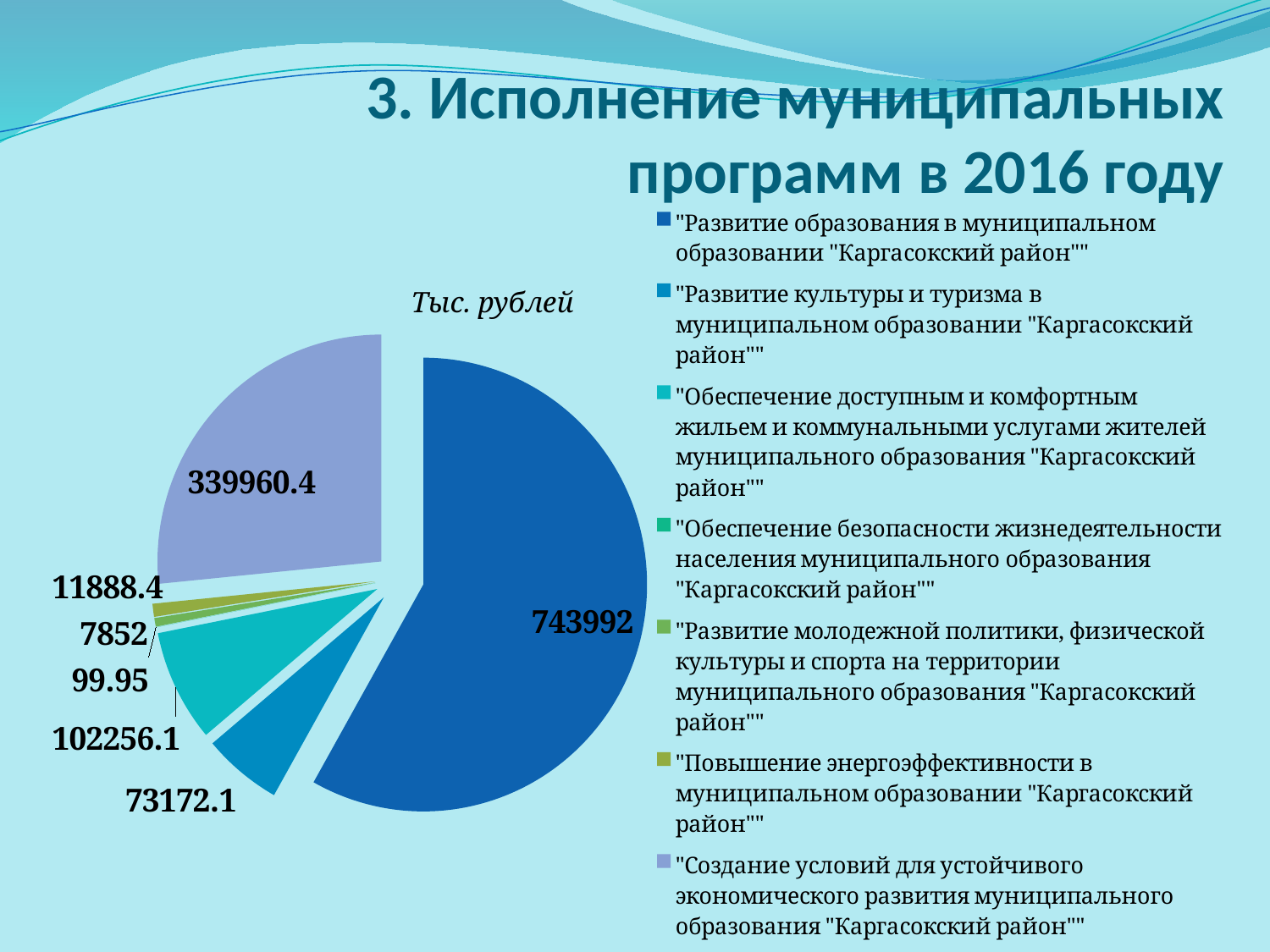
Which is larger: the value for the housing and utilities program or the culture and tourism program? the housing and utilities program (102256.1) What is the value for "Развитие образования в муниципальном образовании "Каргасокский район""? 743992 What is the value for "Обеспечение доступным и комфортным жильем и коммунальными услугами жителей муниципального образования "Каргасокский район""? 102256.1 What is the difference between the value for the education program (743992) and the economic development program (339960.4)? 404031.6 What is the value for "Повышение энергоэффективности в муниципальном образовании "Каргасокский район""? 11888.4 What is the value for "Развитие культуры и туризма в муниципальном образовании "Каргасокский район""? 73172.1 What unit is given in the chart title? Тыс. рублей Which program has the largest slice of the pie? "Развитие образования в муниципальном образовании "Каргасокский район"" What is the value for "Создание условий для устойчивого экономического развития муниципального образования "Каргасокский район""? 339960.4 How many slices does the pie chart have? 7 Which program has the smallest slice of the pie? "Обеспечение безопасности жизнедеятельности населения муниципального образования "Каргасокский район"" What type of chart is shown on the slide? pie chart